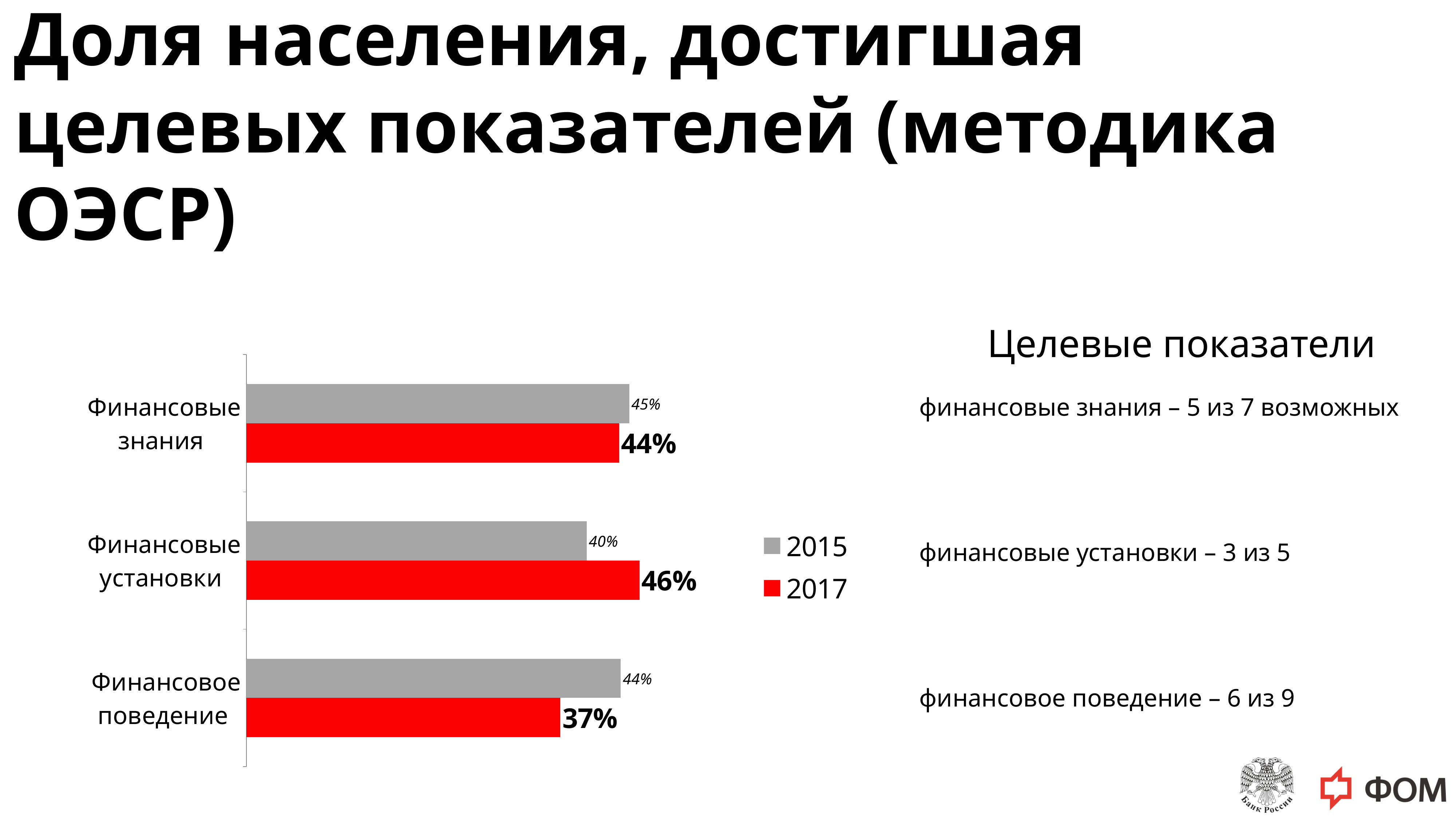
Which is larger for Финансовые установки: the 2015 value or the 2017 value? 2017 How many categories are shown in the chart? 3 What is the 2017 value for Финансовое поведение? 37% What kind of chart is shown on the slide? Bar chart How many series does the legend list? 2 Which category has the highest 2017 value? Финансовые установки Which colour represents the 2017 series in the chart? Red Which category has the lowest 2017 value? Финансовое поведение What is the 2015 value for Финансовое поведение? 44% What is the difference between the 2015 and 2017 values for Финансовое поведение? 7% What is the 2015 value for Финансовые установки? 40% What is the 2017 value for Финансовые знания? 44%